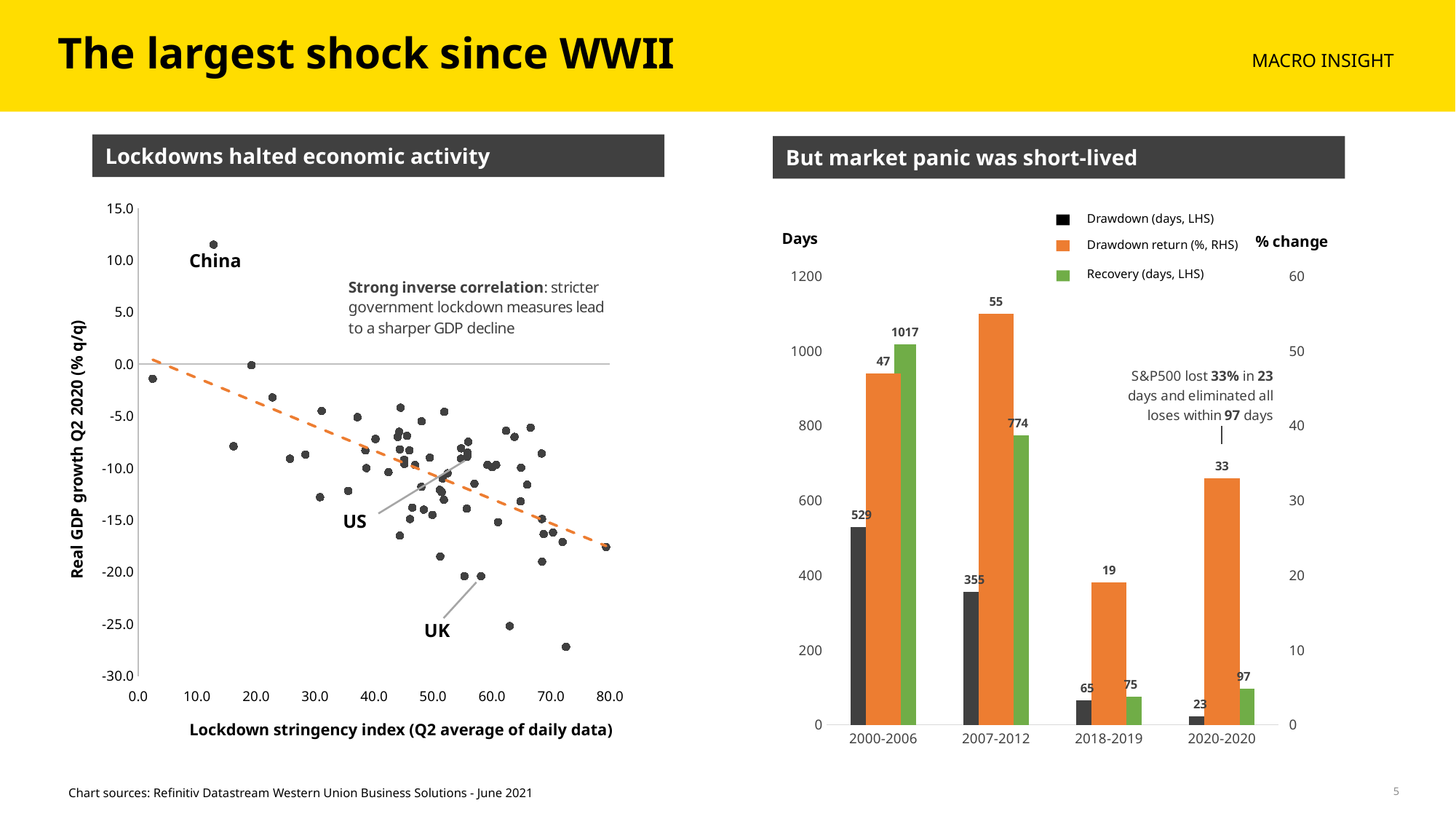
What kind of chart is 'Lockdowns halted economic activity'? Scatter chart On the 'But market panic was short-lived' chart, which period has the lowest Drawdown (days) value? 2020-2020 On the 'But market panic was short-lived' chart, which period has the highest Recovery (days) value? 2000-2006 On the 'But market panic was short-lived' chart, what is the Recovery (days) value for 2007-2012? 774 On the 'But market panic was short-lived' chart, how many periods are shown on the x axis? 4 On the 'But market panic was short-lived' chart, how many series does the legend list? 3 On the 'Lockdowns halted economic activity' chart, what is the label of the x axis? Lockdown stringency index (Q2 average of daily data) On the 'But market panic was short-lived' chart, which is larger: the Drawdown return (%) for 2007-2012 or for 2000-2006? 2007-2012 On the 'Lockdowns halted economic activity' chart, is the Real GDP growth value for China greater or less than 10.0? greater On the 'But market panic was short-lived' chart, what is the Drawdown (days) value for 2000-2006? 529 On the 'But market panic was short-lived' chart, what is the Drawdown return (%) for 2020-2020? 33 On the 'But market panic was short-lived' chart, what is the difference between the Recovery (days) for 2000-2006 and 2007-2012? 243